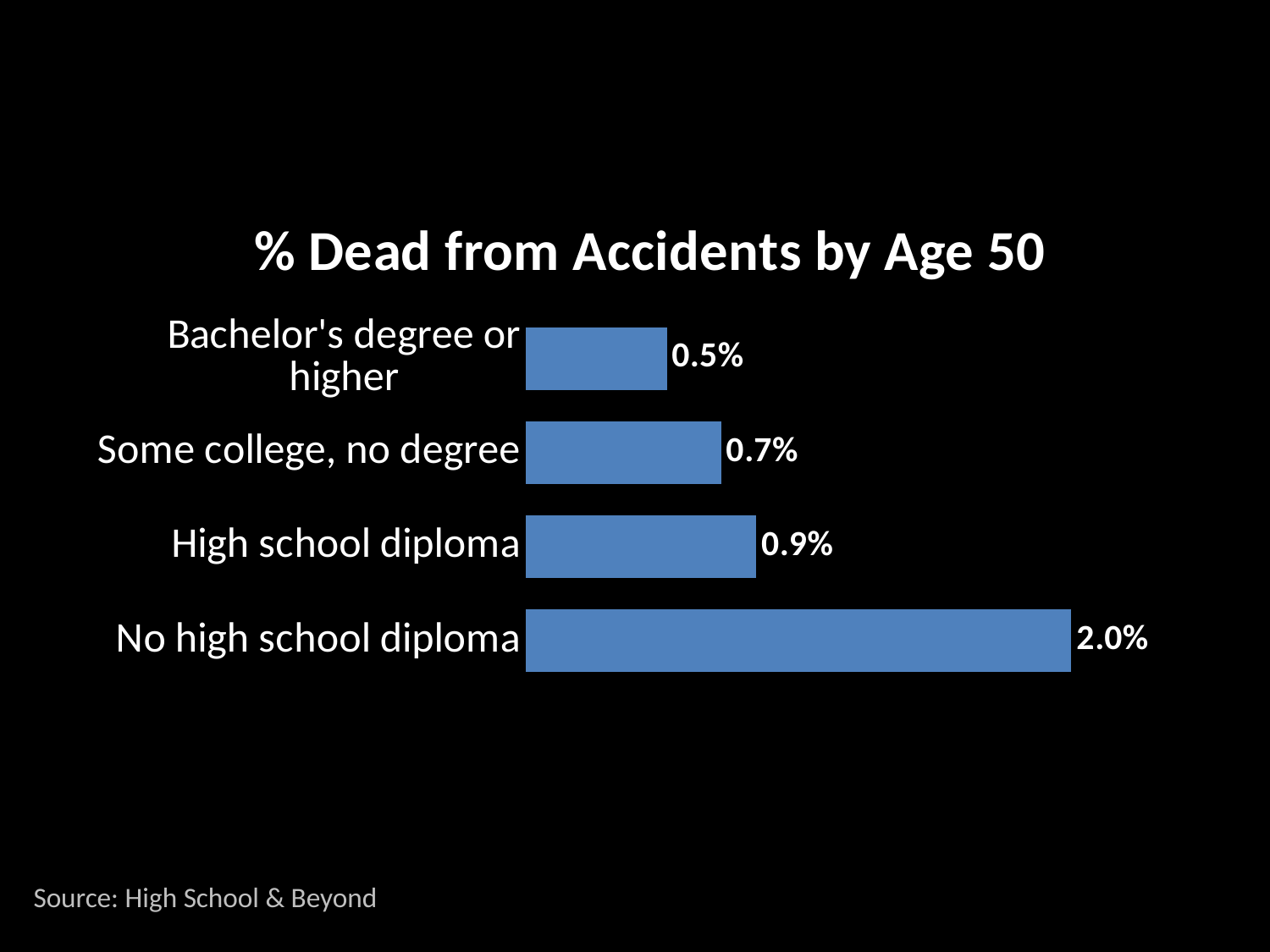
What is the difference between the values for No high school diploma and High school diploma? 1.1% What is the value for No high school diploma? 2.0% What is the value for Bachelor's degree or higher? 0.5% Which is larger, the value for High school diploma or the value for Some college, no degree? High school diploma What is the value for Some college, no degree? 0.7% Which category has the lowest value? Bachelor's degree or higher How many categories are shown in the chart? 4 What is the difference between the values for Some college, no degree and Bachelor's degree or higher? 0.2% What is the value for High school diploma? 0.9% What kind of chart is shown on the slide? Bar chart What is the title of the chart? % Dead from Accidents by Age 50 Which category has the highest value? No high school diploma